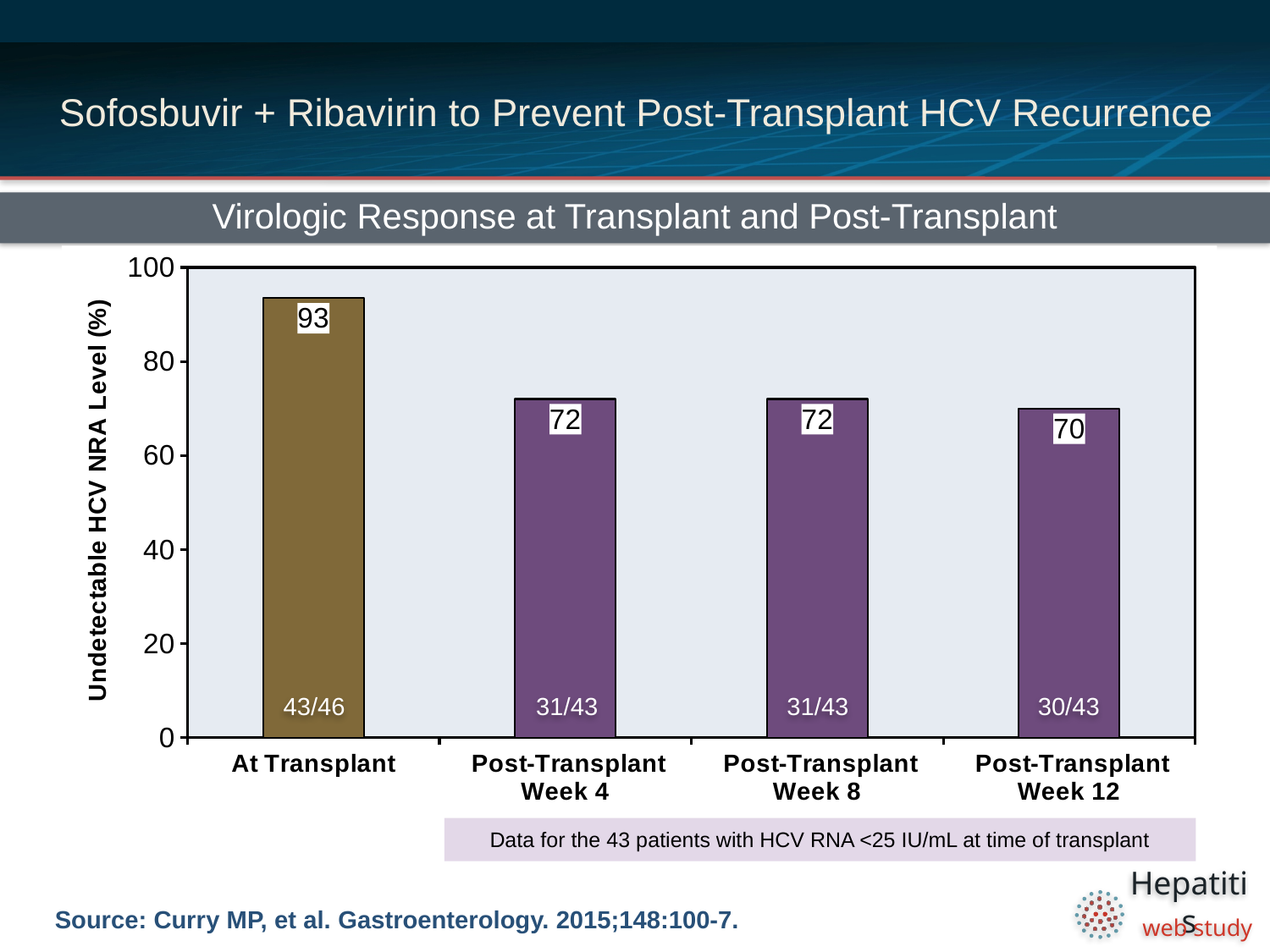
What is the value for At Transplant? 93 What is the value for Post-Transplant Week 4? 72 Which category has the highest value? At Transplant What is the value for Post-Transplant Week 12? 70 What is the fraction label shown at the bottom of the Post-Transplant Week 12 bar? 30/43 Which category has the lowest value? Post-Transplant Week 12 What is the difference between the values for Post-Transplant Week 8 and Post-Transplant Week 12? 2 What kind of chart is shown? bar chart Which is larger, the value for At Transplant or the value for Post-Transplant Week 8? At Transplant Is the value for Post-Transplant Week 4 greater or less than 80? less How many categories are shown on the x axis? 4 What is the difference between the values for At Transplant and Post-Transplant Week 4? 21